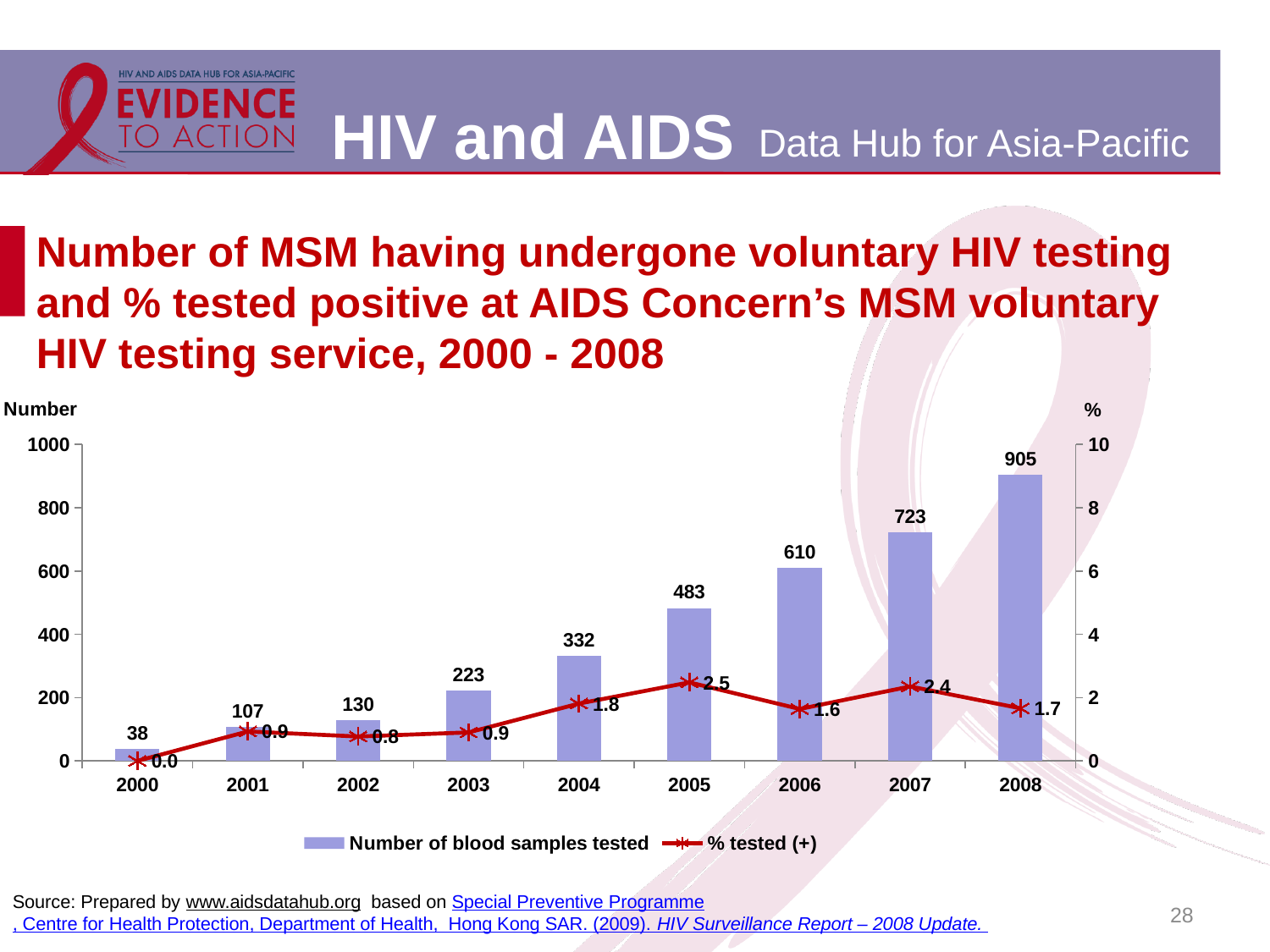
Which year had more blood samples tested, 2004 or 2005? 2005 What was the % tested positive in 2005? 2.5 How many blood samples were tested in 2006? 610 What is the difference in the number of blood samples tested between 2008 and 2007? 182 What kind of chart is used to show the number of blood samples tested? bar chart What is the label of the right-hand vertical axis? % How many series does the legend list? 2 Which year had the lowest number of blood samples tested? 2000 What was the % tested positive in 2000? 0.0 How many years are shown on the x axis? 9 Does the number of blood samples tested rise or fall from 2000 to 2008? rise Which year had the highest number of blood samples tested? 2008